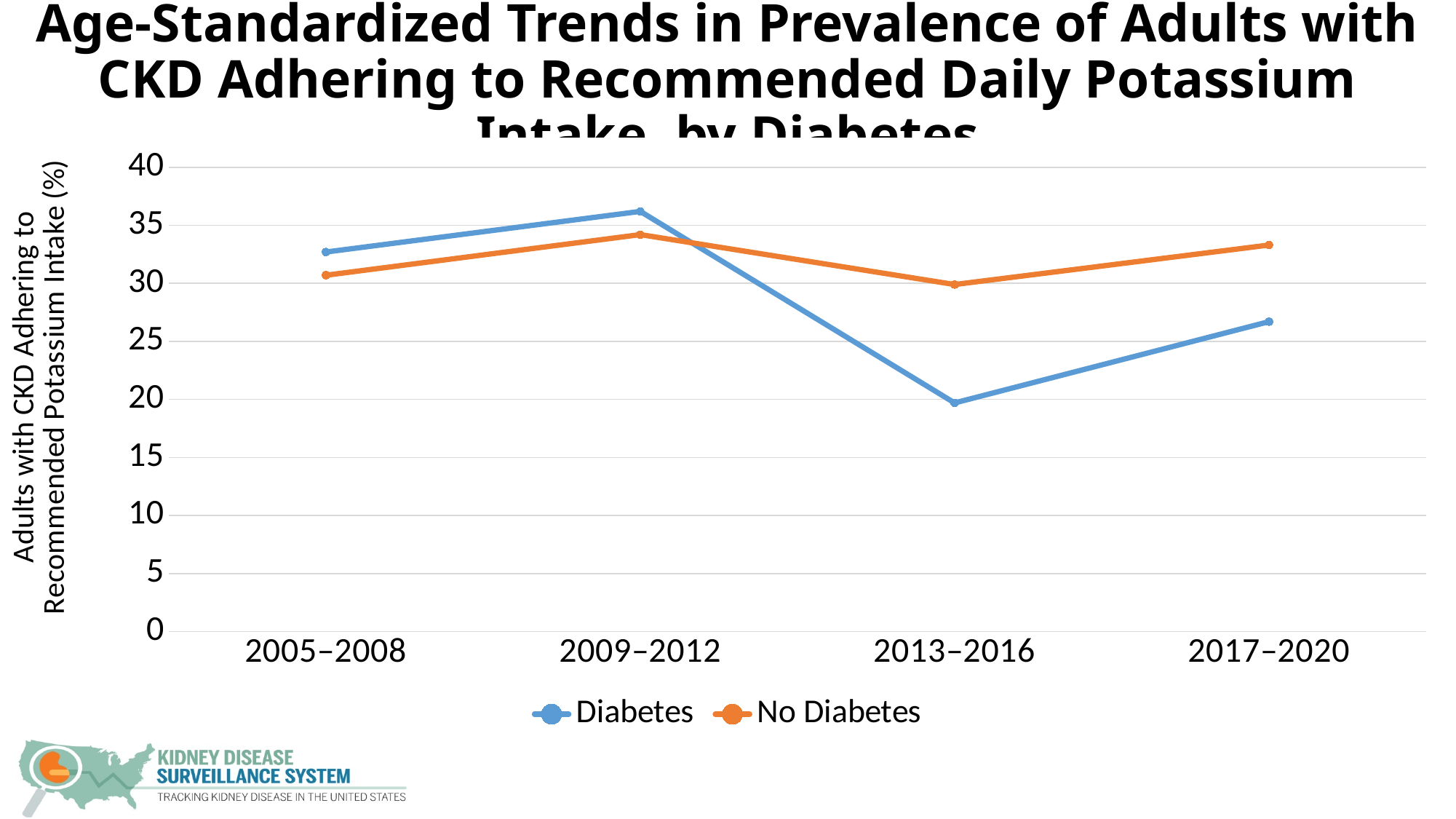
Is the value for Diabetes in 2013–2016 greater or less than 25? less How many series does the legend list? 2 In 2013–2016, which series has the higher value, Diabetes or No Diabetes? No Diabetes In which period is the Diabetes series at its highest? 2009–2012 In 2005–2008, which series has the higher value, Diabetes or No Diabetes? Diabetes In which period is the No Diabetes series at its highest? 2009–2012 In which period is the No Diabetes series at its lowest? 2013–2016 Does the Diabetes series rise or fall from 2009–2012 to 2013–2016? fall What kind of chart is shown on the slide? line chart In which period is the Diabetes series at its lowest? 2013–2016 Which colour is used for the No Diabetes series? orange How many time periods are shown on the x axis? 4